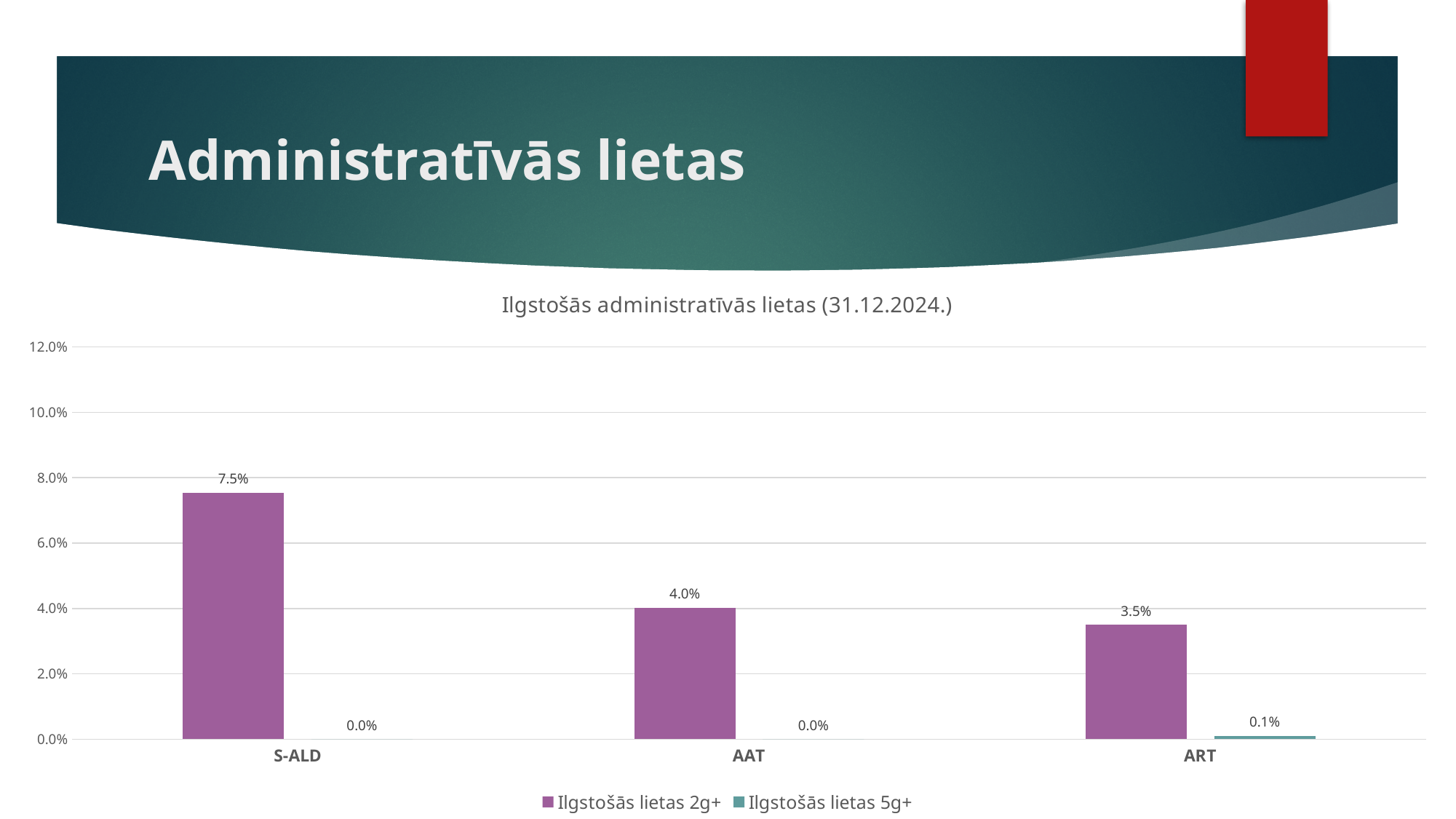
What is the value of Ilgstošās lietas 2g+ for AAT? 4.0% What is the value of Ilgstošās lietas 2g+ for S-ALD? 7.5% What kind of chart is shown on the slide? Bar chart How many categories are shown on the x axis? 3 What is the difference between the Ilgstošās lietas 2g+ values for S-ALD and AAT? 3.5% What is the value of Ilgstošās lietas 5g+ for ART? 0.1% What is the title of the chart? Ilgstošās administratīvās lietas (31.12.2024.) Which is larger, the Ilgstošās lietas 2g+ value for AAT or for ART? AAT Which category has the lowest value for Ilgstošās lietas 2g+? ART What is the value of Ilgstošās lietas 2g+ for ART? 3.5% How many series does the legend list? 2 Which category has the highest value for Ilgstošās lietas 2g+? S-ALD